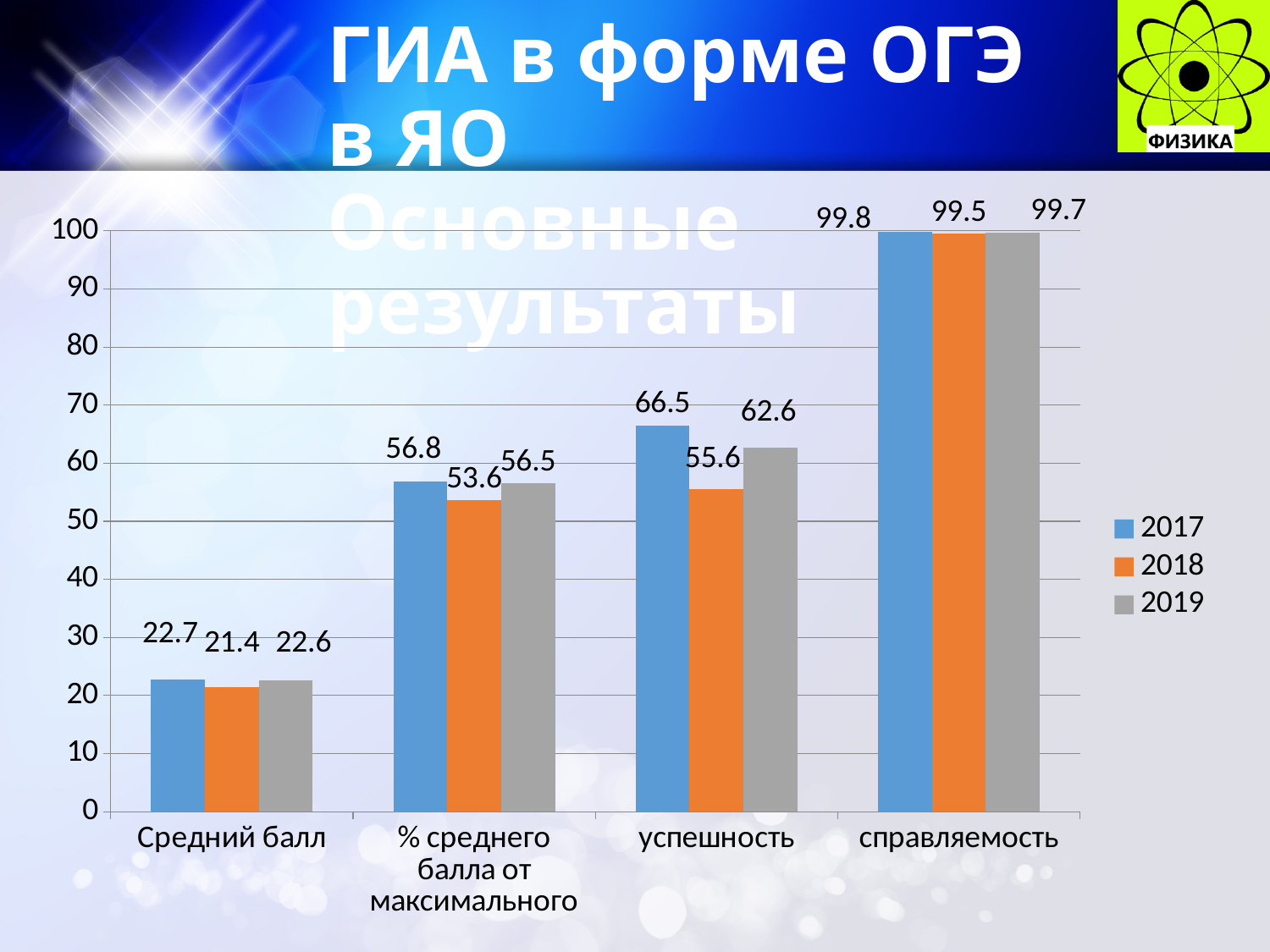
What is the value for 2019 in the справляемость category? 99.7 What is the value for 2017 in the Средний балл category? 22.7 How many categories are shown on the x axis? 4 What kind of chart is shown on the slide? bar chart Which is larger: the 2017 value or the 2019 value in the % среднего балла от максимального category? 2017 How many series does the legend list? 3 Which colour represents the 2018 series in the legend? orange What is the value for 2018 in the успешность category? 55.6 Which year has the lowest value in the Средний балл category? 2018 Which year has the highest value in the успешность category? 2017 What is the value for 2018 in the % среднего балла от максимального category? 53.6 What is the difference between the 2017 and 2019 values in the успешность category? 3.9